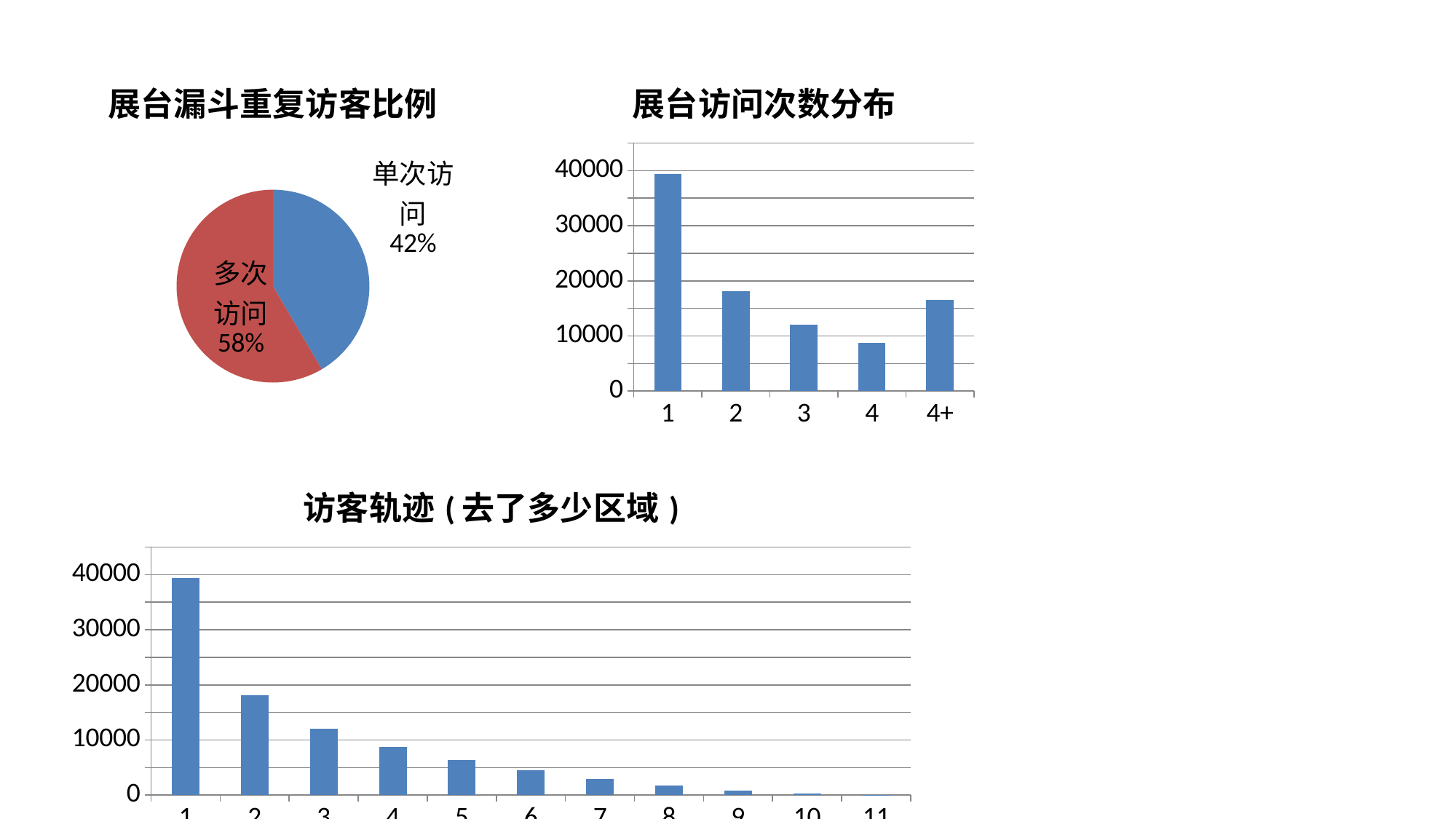
How many categories are shown on the x axis of the chart titled 访客轨迹（去了多少区域）? 11 In the chart titled 展台漏斗重复访客比例, which slice is larger, 单次访问 or 多次访问? 多次访问 In the chart titled 展台访问次数分布, which category has the lowest value? 4 In the chart titled 展台访问次数分布, which category has the highest value? 1 In the chart titled 访客轨迹（去了多少区域）, do the values rise or fall as you move from category 1 to category 11? Fall In the chart titled 展台访问次数分布, which is larger, the value for 2 or the value for 4+? 2 In the chart titled 展台访问次数分布, is the value for category 1 greater or less than 30000? greater How many categories are shown on the x axis of the chart titled 展台访问次数分布? 5 In the chart titled 展台漏斗重复访客比例, what percentage is shown for 单次访问? 42% In the chart titled 展台访问次数分布, is the value for category 4 greater or less than 10000? less What kind of chart is the one titled 展台漏斗重复访客比例? Pie chart In the chart titled 展台漏斗重复访客比例, what share of the pie does 多次访问 take? 58%